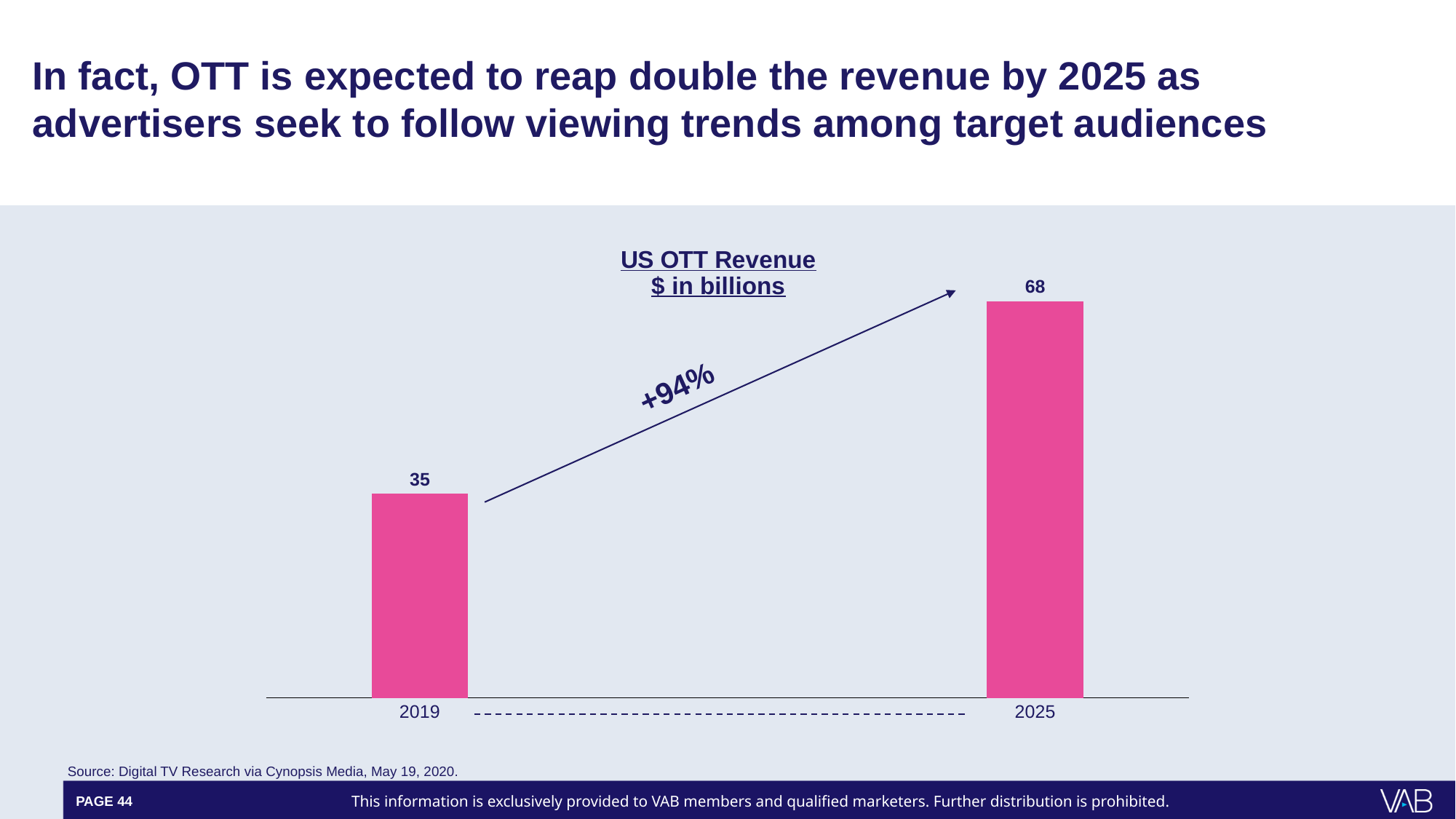
Which year has the higher US OTT revenue? 2025 Is the US OTT revenue for 2025 larger or smaller than for 2019? larger How many years are plotted in the chart? 2 What percentage change is labelled on the arrow between the two bars? +94% Which year has the lower US OTT revenue? 2019 What is the difference between the 2025 and 2019 US OTT revenue values? 33 What is the US OTT revenue value shown for 2025? 68 What is the US OTT revenue value shown for 2019? 35 What is the title of the chart? US OTT Revenue $ in billions Do the values rise or fall from 2019 to 2025? rise What kind of chart is shown on the slide? bar chart